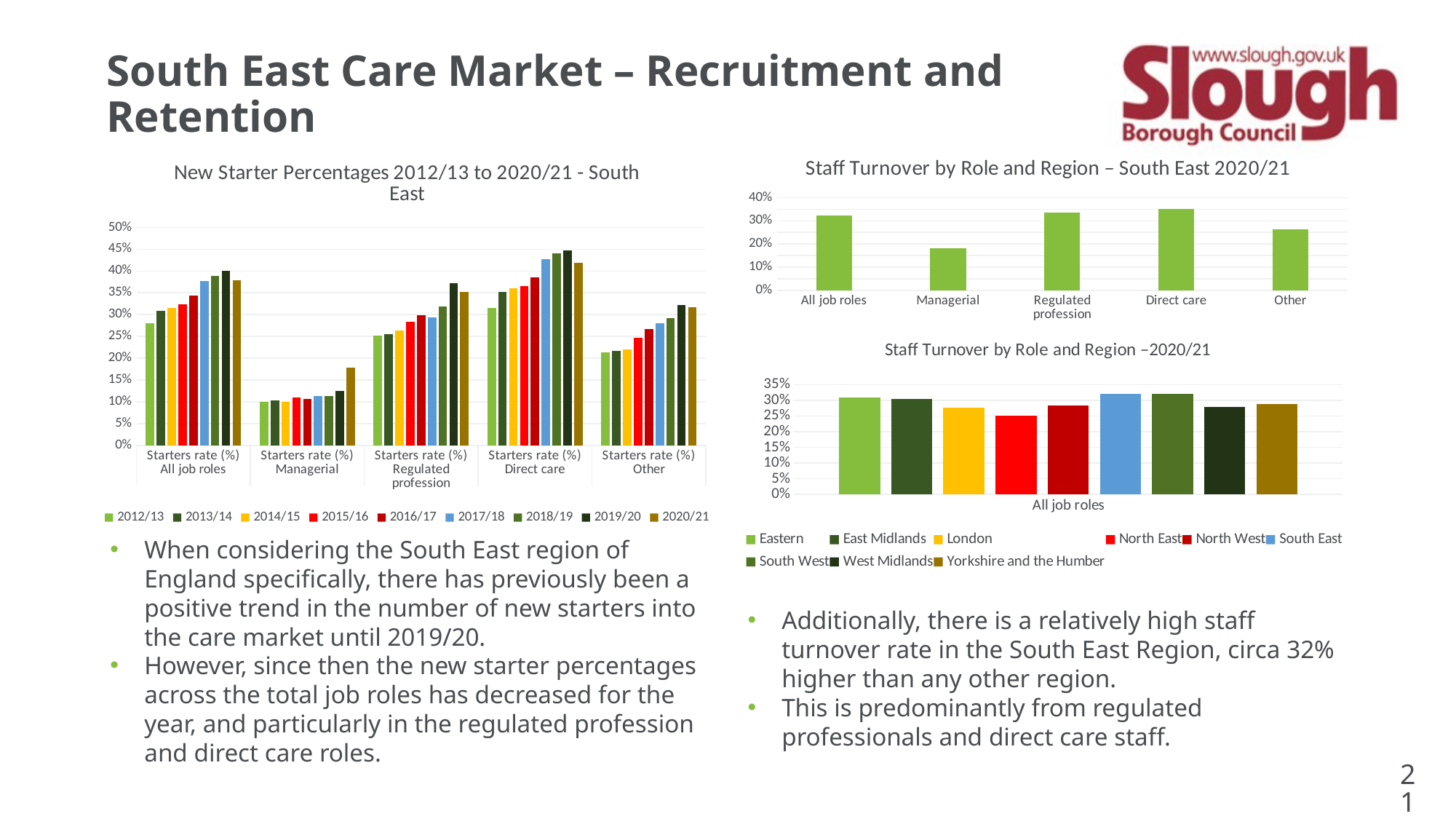
In the chart titled 'Staff Turnover by Role and Region – South East 2020/21', which role has the lowest turnover? Managerial How many regions does the legend list in the chart titled 'Staff Turnover by Role and Region –2020/21' (bottom right)? 9 In the chart titled 'Staff Turnover by Role and Region – South East 2020/21', is the value for Managerial greater or less than 20%? less What kind of chart is the chart titled 'New Starter Percentages 2012/13 to 2020/21 - South East'? Bar chart In the chart titled 'Staff Turnover by Role and Region –2020/21' (bottom right), which region has the lowest turnover for All job roles? North East In the chart titled 'Staff Turnover by Role and Region – South East 2020/21', which role has the highest turnover? Direct care How many role categories are shown in the chart titled 'Staff Turnover by Role and Region – South East 2020/21'? 5 In the chart titled 'Staff Turnover by Role and Region – South East 2020/21', is the value for Regulated profession greater or less than 30%? greater How many year series does the legend list in the chart titled 'New Starter Percentages 2012/13 to 2020/21 - South East'? 9 In the chart titled 'New Starter Percentages 2012/13 to 2020/21 - South East', is the 2019/20 value for Starters rate (%) Direct care greater or less than 40%? greater In the chart titled 'New Starter Percentages 2012/13 to 2020/21 - South East', which job role category has the lowest starters rates? Starters rate (%) Managerial